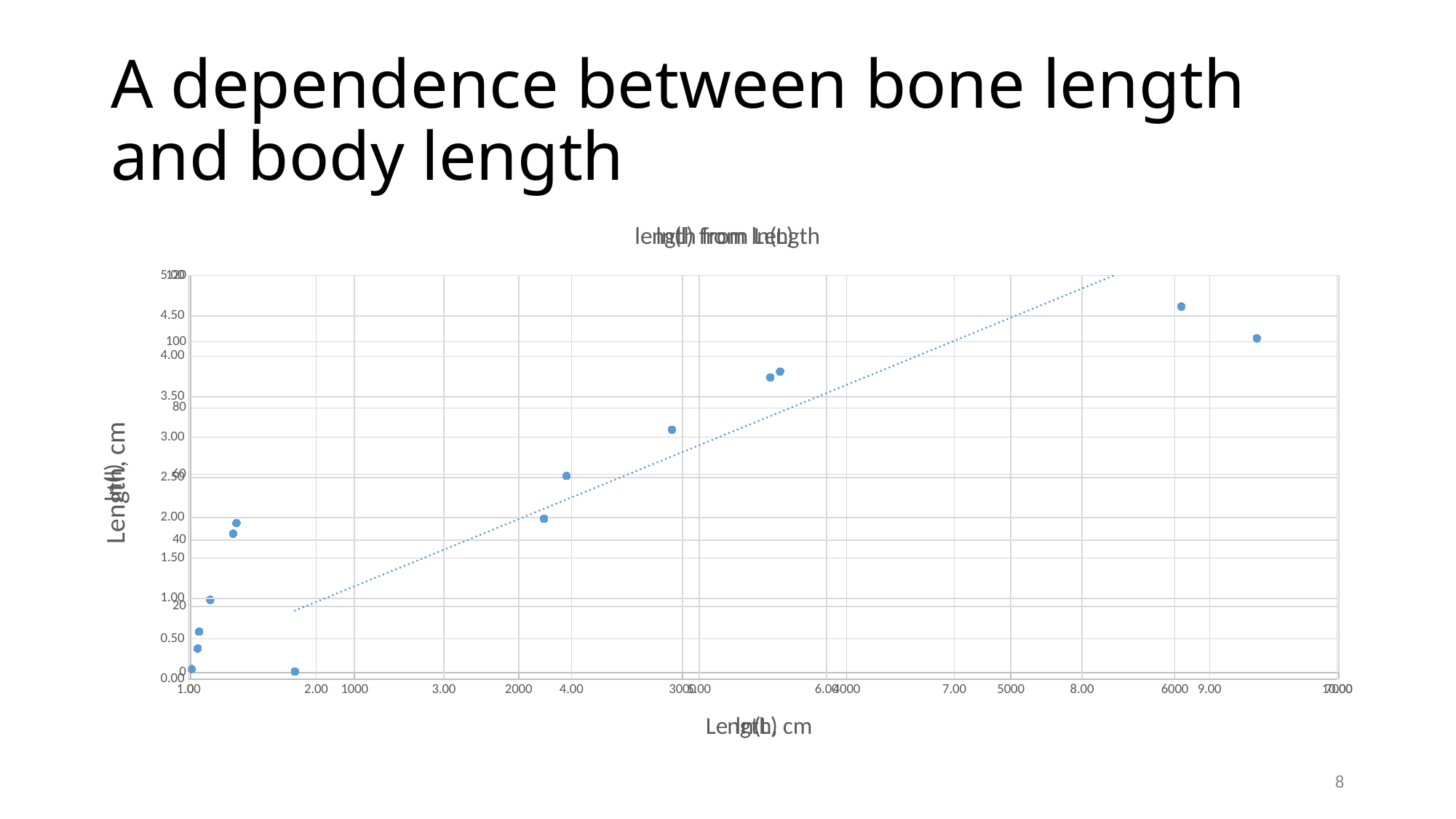
What kind of chart is shown on the slide? scatter chart On the 0.00–5.00 vertical scale, is the value of the rightmost plotted point greater or less than 4.00? greater Is the highest plotted point also the rightmost plotted point? No Do the plotted points generally rise or fall as you move from left to right along the x axis? rise On the 0.00–5.00 vertical scale, is the value of the leftmost plotted point greater or less than 0.50? less Does the chart include a dotted trend line through the points? Yes